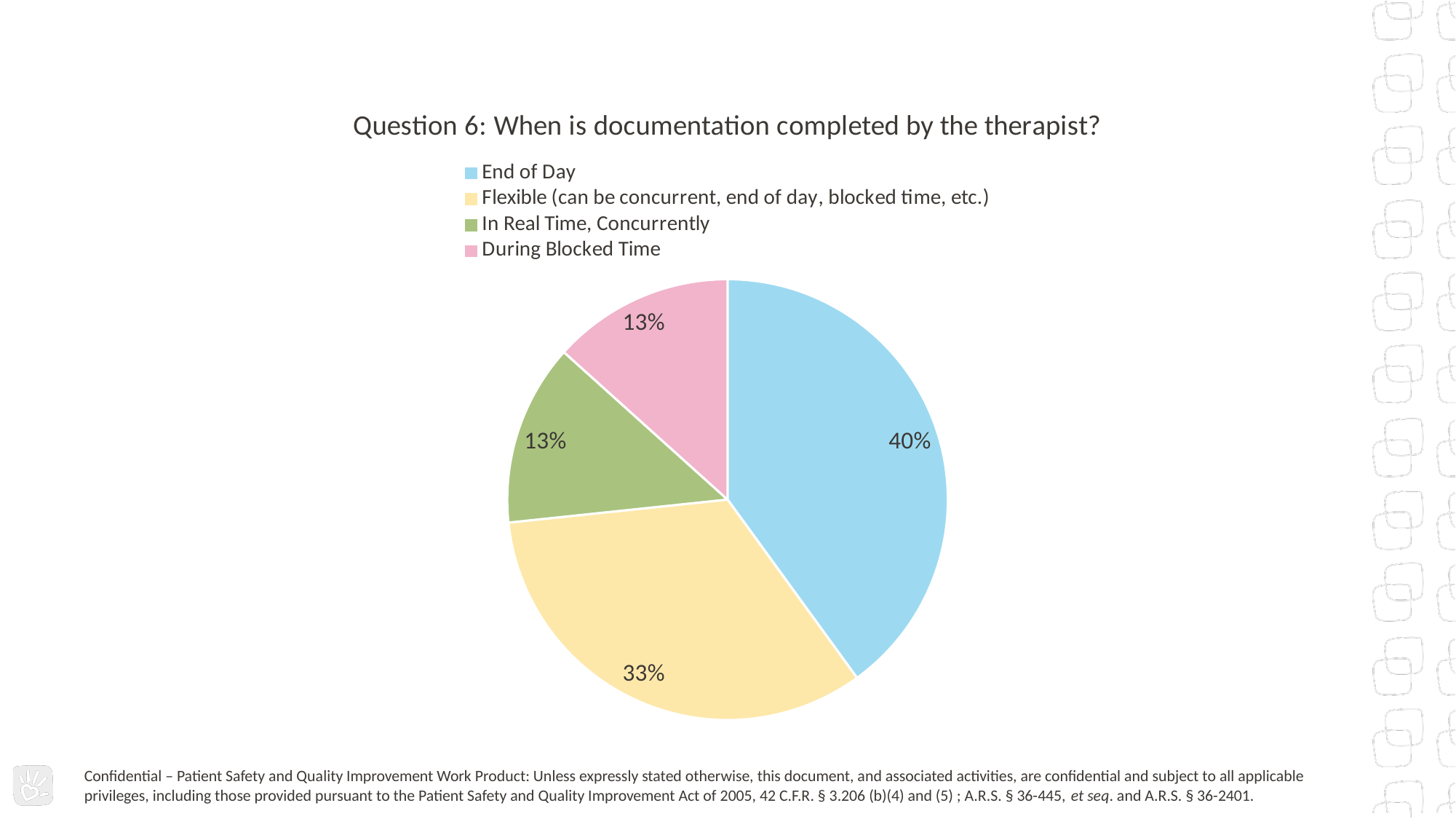
Which category has the largest slice of the pie? End of Day What share of the pie is labelled for End of Day? 40% What colour is the End of Day slice? light blue What share of the pie is labelled for In Real Time, Concurrently? 13% What share of the pie is labelled for During Blocked Time? 13% What kind of chart is shown on the slide? pie chart Which is larger, the share for End of Day or the share for During Blocked Time? End of Day How many entries does the legend list? 4 What is the difference between the End of Day share and the Flexible share? 7% How many slices does the pie chart have? 4 What is the title of the chart? Question 6: When is documentation completed by the therapist?